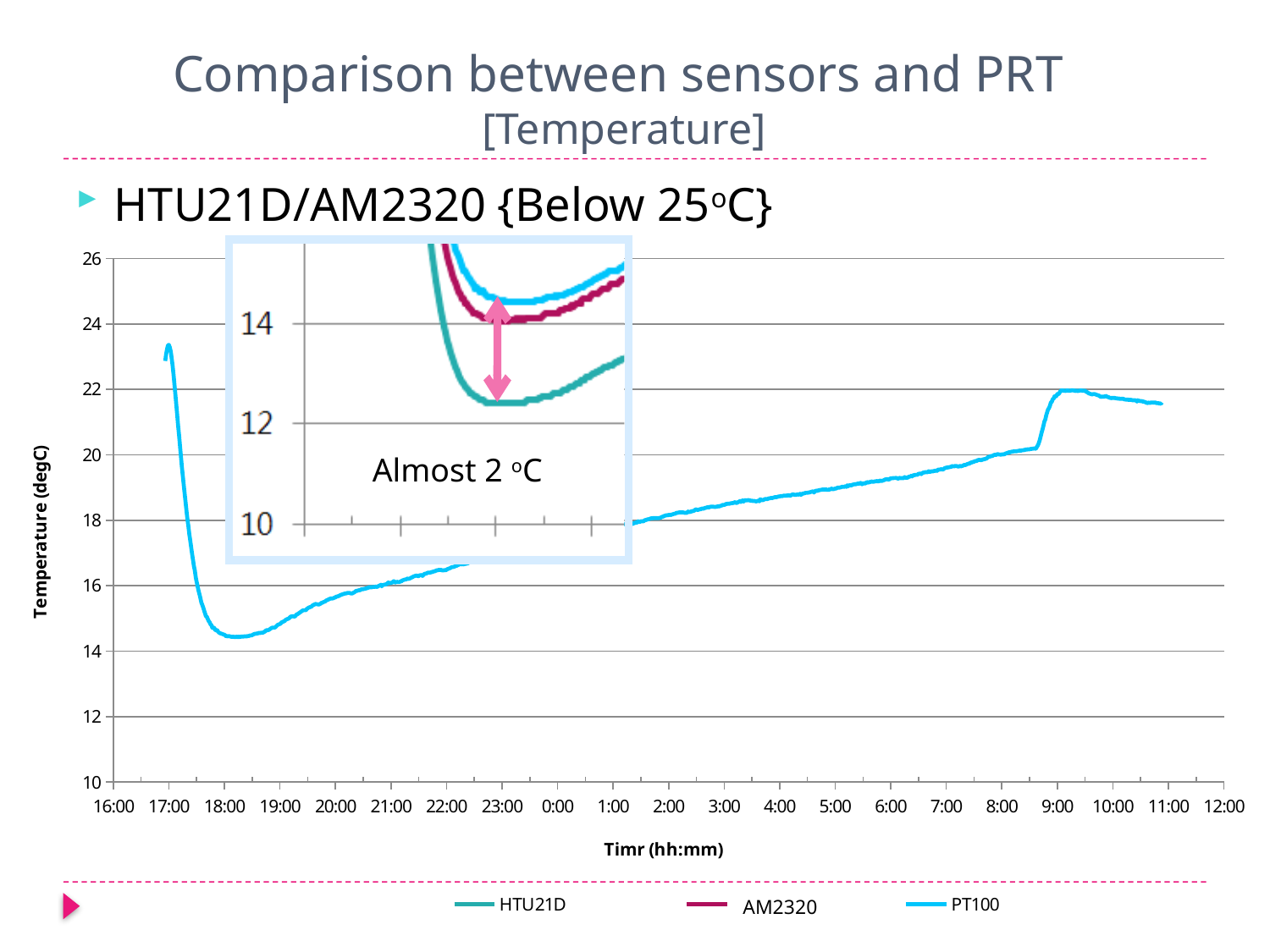
Between 19:00 and 8:00, does the plotted temperature rise or fall? rise How many series does the legend list? 3 What kind of chart is shown on the slide? line chart Is the temperature value at 5:00 greater or less than 18? greater Is the temperature value at 22:00 greater or less than 18? less Is the temperature value at 17:00 greater or less than 22? greater What is the label of the y axis? Temperature (degC) In the zoomed inset, which series has the highest values? PT100 In the zoomed inset, which series has the lowest values? HTU21D What difference does the annotation in the zoomed inset state? Almost 2 °C